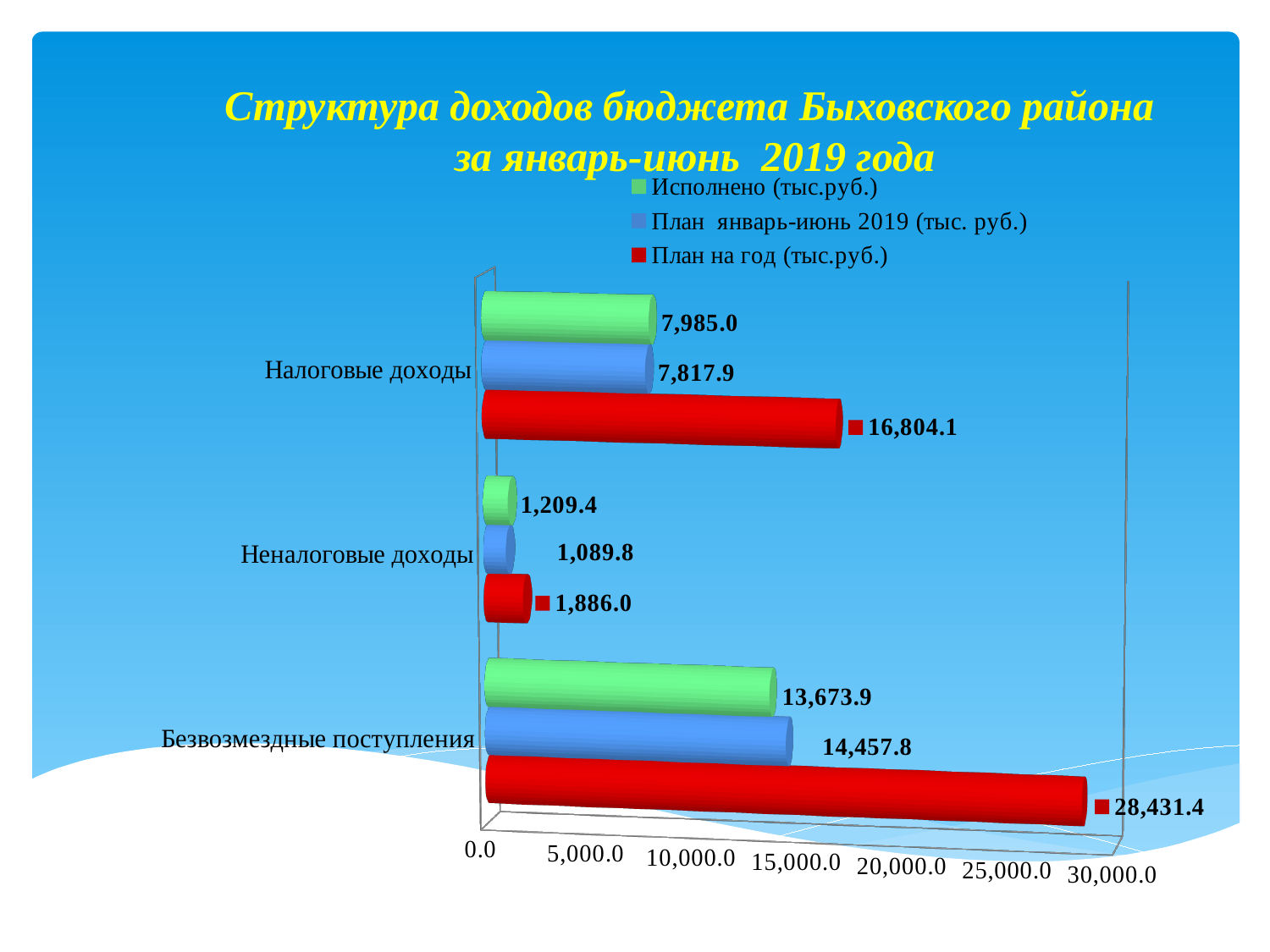
Is the value of "План на год (тыс.руб.)" for Безвозмездные поступления greater or less than 25,000.0? greater Which category has the highest value for "План на год (тыс.руб.)"? Безвозмездные поступления Which category has the lowest value for "Исполнено (тыс.руб.)"? Неналоговые доходы What is the difference between "План на год (тыс.руб.)" and "Исполнено (тыс.руб.)" for Налоговые доходы? 8,819.1 What is the value of "План на год (тыс.руб.)" for Безвозмездные поступления? 28,431.4 What type of chart is shown on the slide? Bar chart How many categories are shown on the chart? 3 How many series does the legend list? 3 For Безвозмездные поступления, which is larger: "Исполнено (тыс.руб.)" or "План январь-июнь 2019 (тыс. руб.)"? План январь-июнь 2019 (тыс. руб.) What is the value of "Исполнено (тыс.руб.)" for Налоговые доходы? 7,985.0 What is the value of "План январь-июнь 2019 (тыс. руб.)" for Неналоговые доходы? 1,089.8 What colour represents the series "План на год (тыс.руб.)"? Red